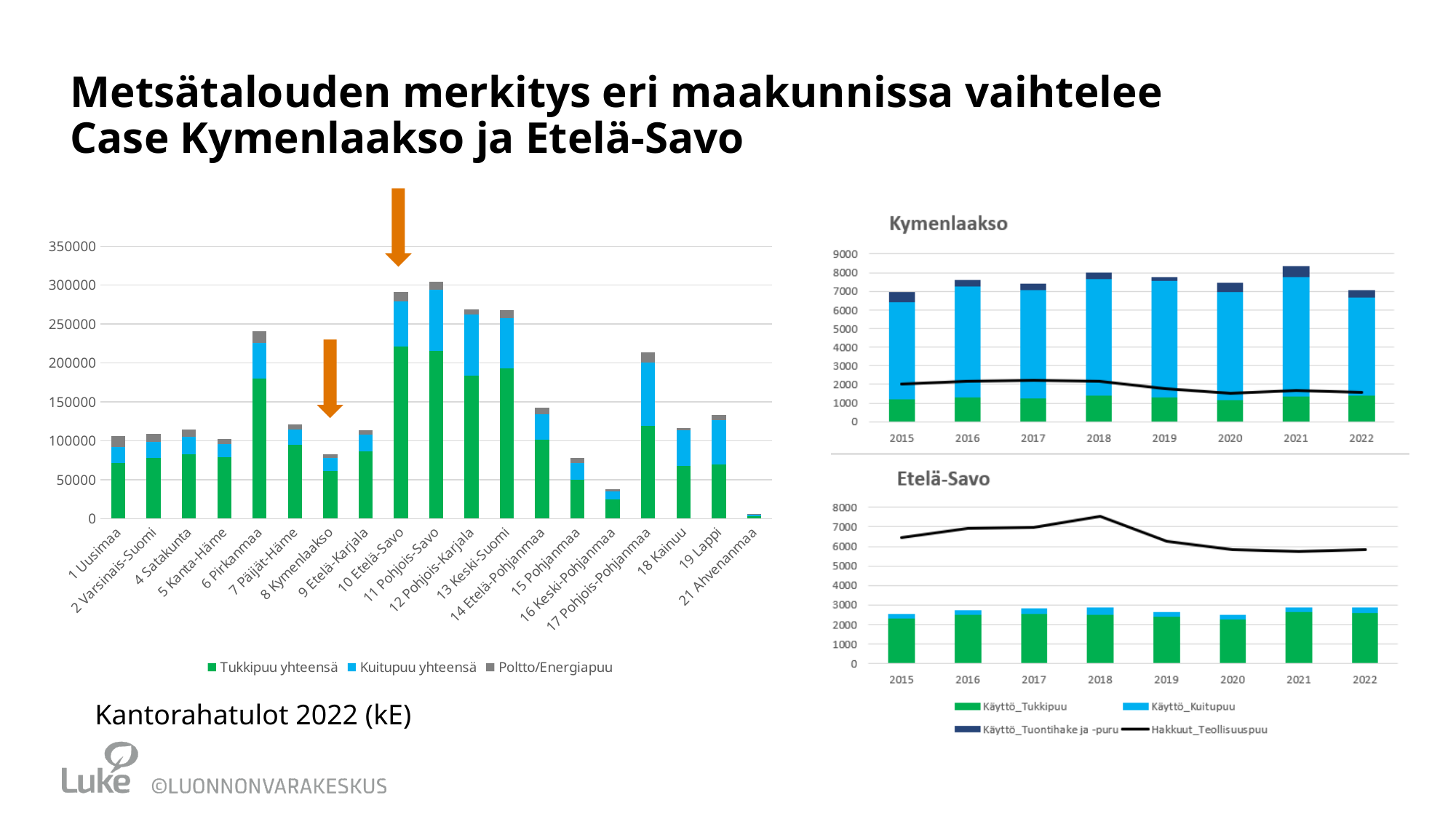
On the Kantorahatulot 2022 chart on the left, which is larger, the total bar for 10 Etelä-Savo or for 8 Kymenlaakso? 10 Etelä-Savo On the Etelä-Savo chart, is the Hakkuut_Teollisuuspuu line value for 2018 greater or less than 7000? greater What kind of chart is the Etelä-Savo chart? Stacked bar chart with a line On the Kantorahatulot 2022 chart on the left, which region has the highest total bar? 11 Pohjois-Savo On the Kymenlaakso chart, which year has the highest total bar? 2021 On the Kymenlaakso chart, is the total bar for 2021 greater or less than 8000? greater On the Kantorahatulot 2022 chart on the left, which region has the lowest total bar? 21 Ahvenanmaa On the Kantorahatulot 2022 chart on the left, how many series does the legend list? 3 On the Kantorahatulot 2022 chart on the left, is the total value for 8 Kymenlaakso greater or less than 100000? less On the Etelä-Savo chart, in which year does the Hakkuut_Teollisuuspuu line reach its highest point? 2018 On the Kantorahatulot 2022 chart on the left, how many regions are shown on the x axis? 19